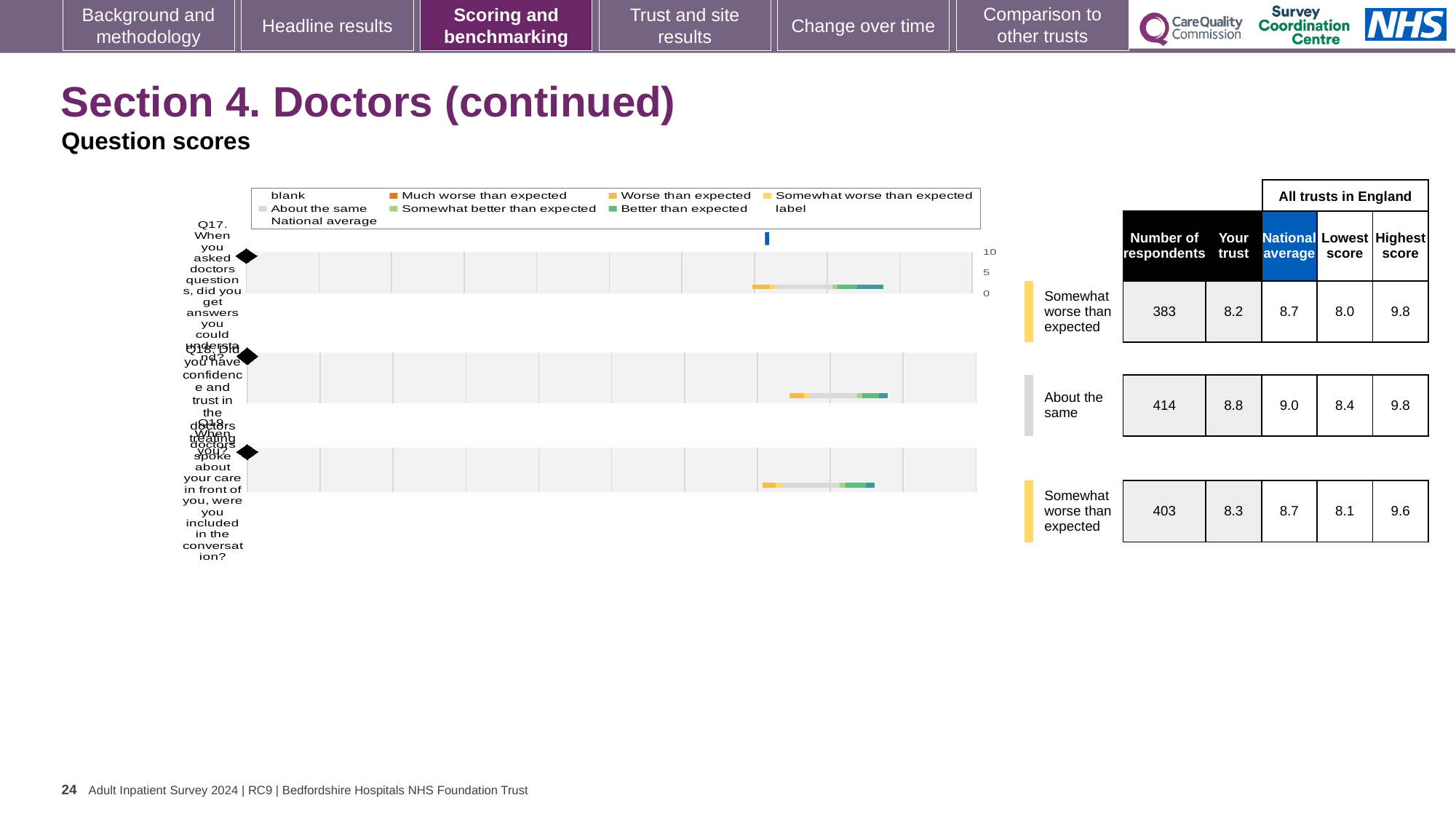
What benchmark category is Q18 assigned to in the labels beside the chart? About the same According to the table beside the chart, how many respondents answered Q19? 403 What kind of chart is shown on the slide? bar chart According to the table beside the chart, what is the national average for Q17? 8.7 Which question has the highest number of respondents in the table beside the chart? Q18 How many questions (categories) are plotted in the chart? 3 Is the 'Your trust' score higher for Q18 or for Q19? Q18 According to the table beside the chart, what is the highest score among all trusts in England for Q19? 9.6 According to the table beside the chart, what is the 'Your trust' score for Q18 (confidence and trust in doctors)? 8.8 What is the title of the slide containing the chart? Section 4. Doctors (continued) Which question has the lowest 'Your trust' score in the table beside the chart? Q17 What is the difference between the national average and the 'Your trust' score for Q17? 0.5